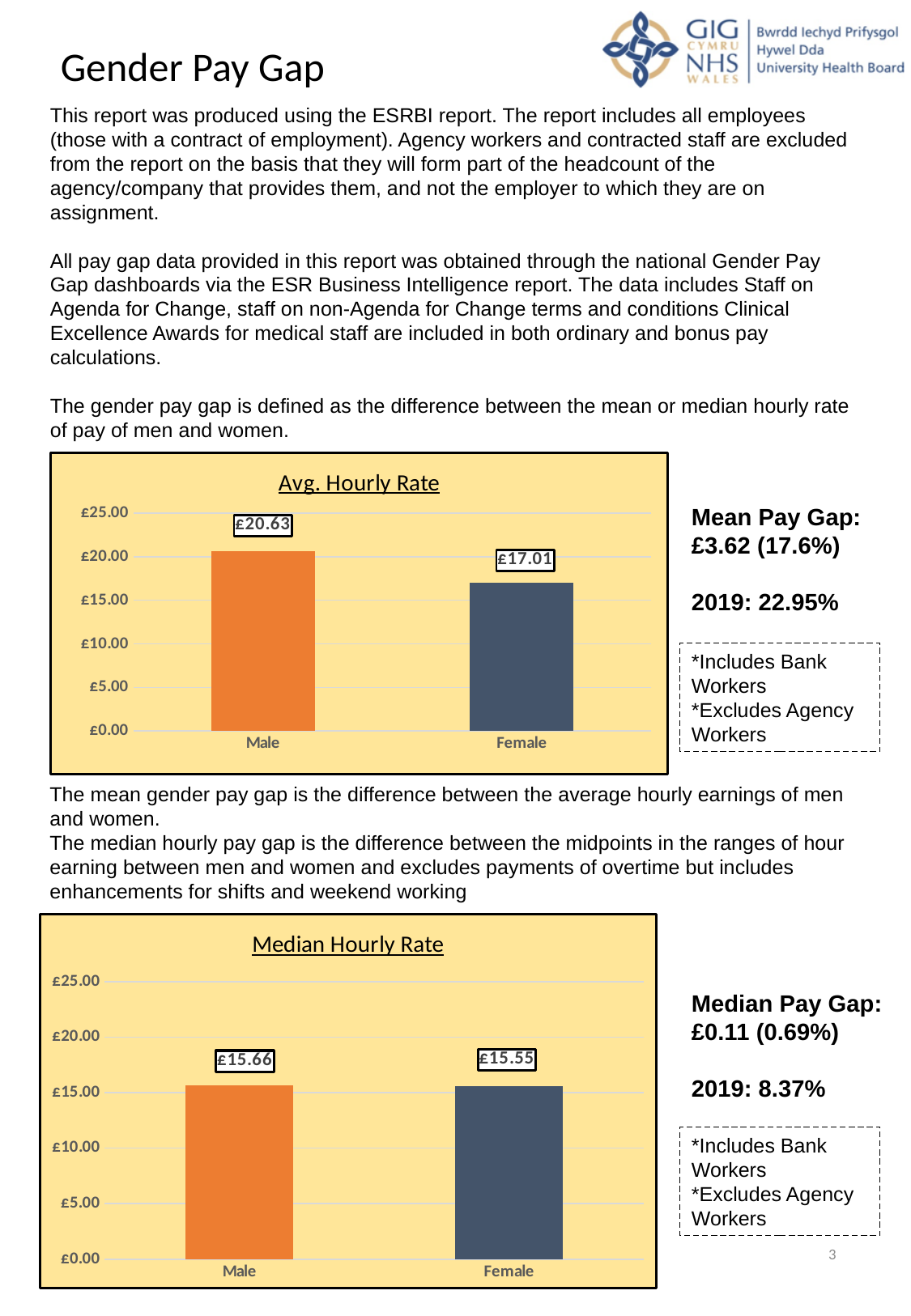
In the Avg. Hourly Rate chart, which category has the higher value? Male In the Avg. Hourly Rate chart, what is the value for Female? £17.01 What type of chart is the Avg. Hourly Rate chart? bar chart In the Avg. Hourly Rate chart, how many categories are shown? 2 In the Avg. Hourly Rate chart, what is the value for Male? £20.63 In the Median Hourly Rate chart, is the value for Male greater or less than £20.00? less In the Median Hourly Rate chart, what is the value for Female? £15.55 In the Median Hourly Rate chart, what is the value for Male? £15.66 In the Avg. Hourly Rate chart, is the value for Female greater or less than £20.00? less In the Median Hourly Rate chart, what is the difference between the Male and Female values? £0.11 In the Median Hourly Rate chart, what colour is the Female bar? dark blue-grey In the Avg. Hourly Rate chart, what is the difference between the Male and Female values? £3.62